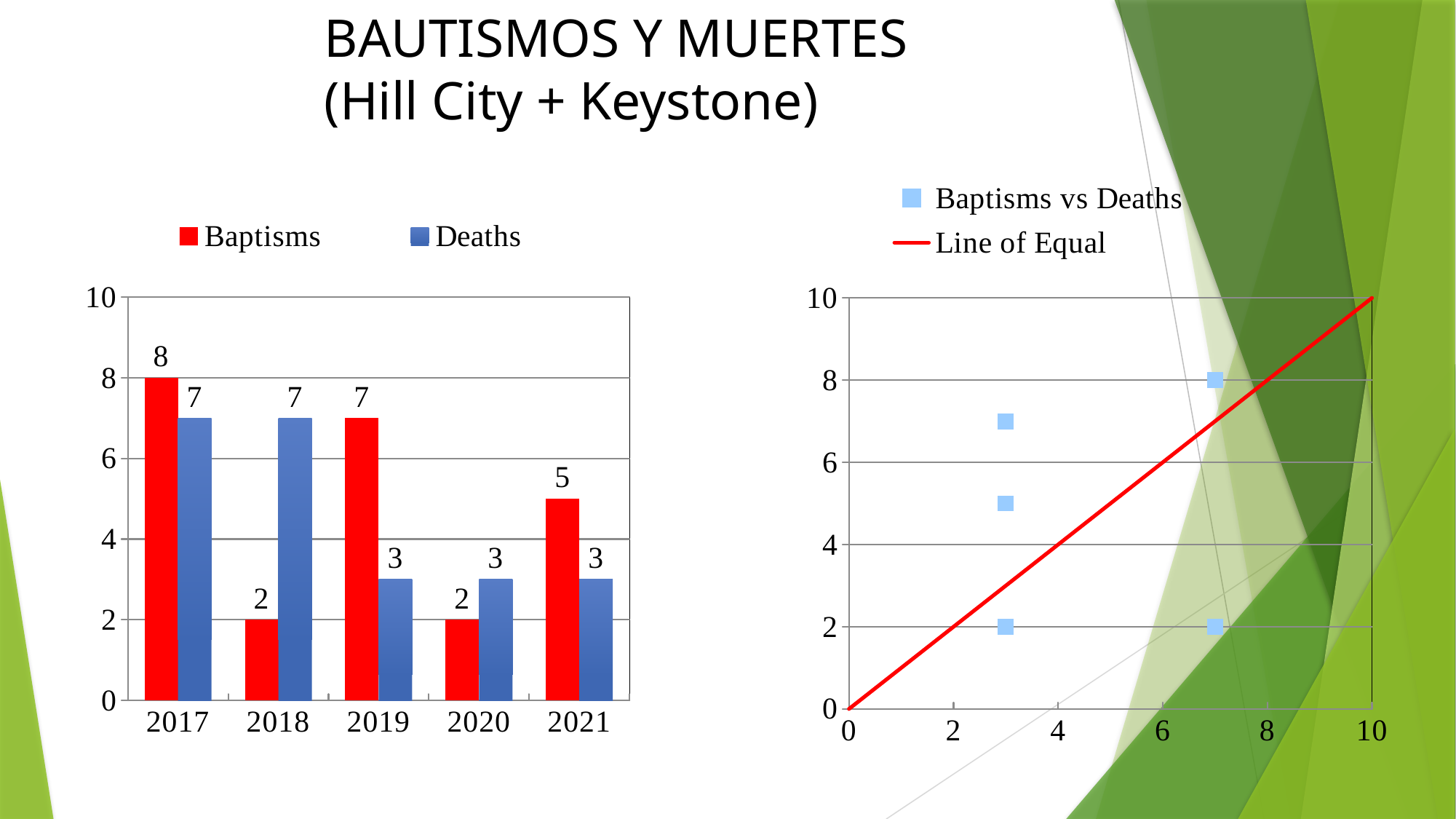
On the left bar chart, what is the value for Deaths in 2018? 7 What kind of chart is the chart on the left of the slide? Bar chart On the left bar chart, which year has the lowest number of Deaths? 2019, 2020 and 2021 (all 3) On the right chart, what are the two entries listed in the legend? Baptisms vs Deaths; Line of Equal On the left bar chart, what is the difference between Baptisms and Deaths in 2018? 5 On the left bar chart, how many years are shown on the x axis? 5 On the left bar chart, how many series does the legend list? 2 On the left bar chart, what is the value for Baptisms in 2017? 8 On the left bar chart, which is larger in 2019, Baptisms or Deaths? Baptisms On the left bar chart, what is the value for Baptisms in 2021? 5 On the left bar chart, which year has the highest number of Baptisms? 2017 On the right chart, how many data points are plotted for the Baptisms vs Deaths series? 5